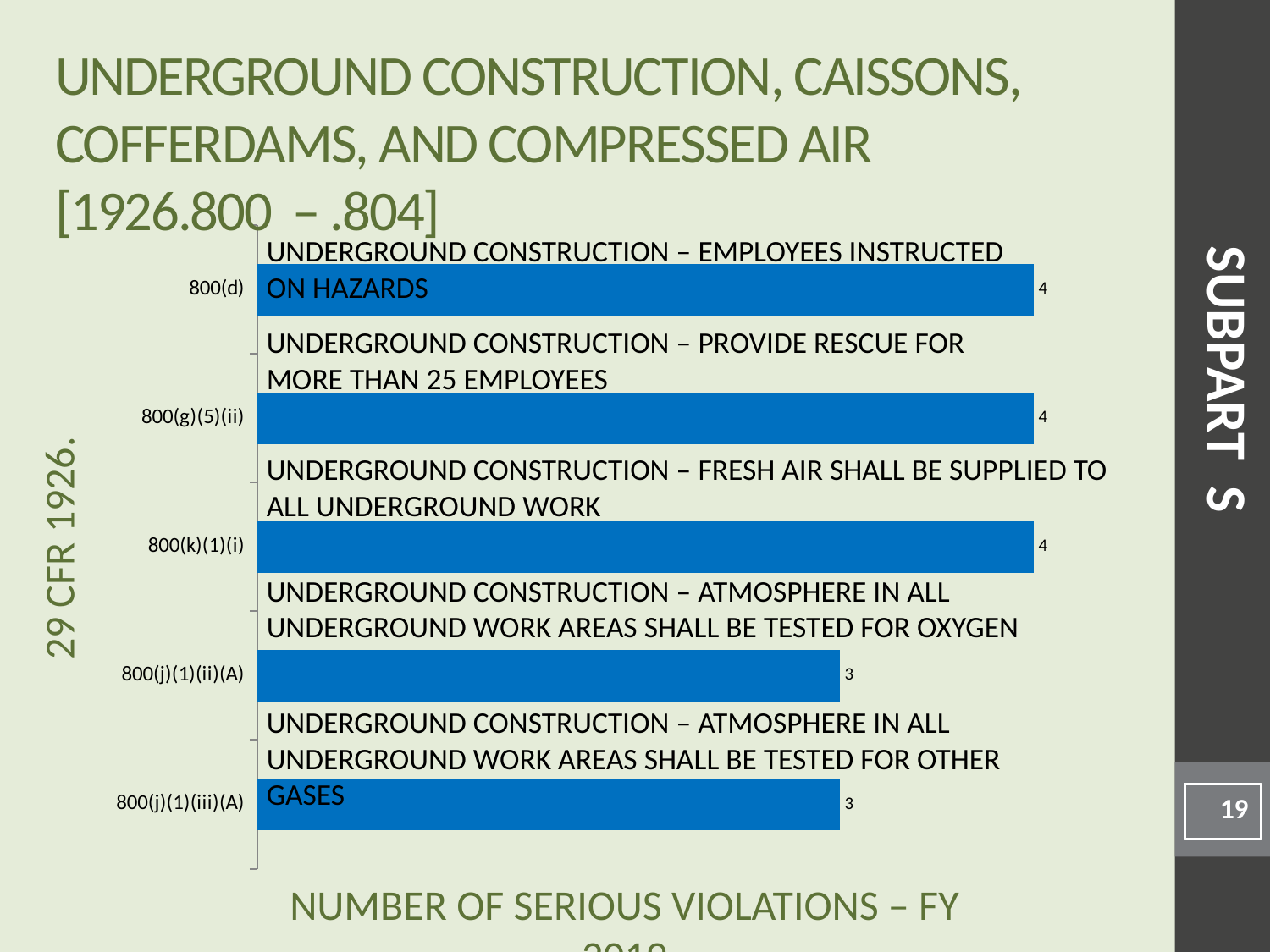
Which has more serious violations, 800(k)(1)(i) or 800(j)(1)(ii)(A)? 800(k)(1)(i) What is the number of serious violations for 800(j)(1)(iii)(A)? 3 How many categories (standards) are shown in the chart? 5 What is the difference between the values for 800(d) and 800(j)(1)(iii)(A)? 1 What is the number of serious violations for 800(d)? 4 What kind of chart is shown on the slide? Bar chart What is the vertical axis title of the chart? 29 CFR 1926. How many of the categories have a value of 4? 3 What is the number of serious violations for 800(j)(1)(ii)(A)? 3 What is the number of serious violations for 800(g)(5)(ii)? 4 What is the number of serious violations for 800(k)(1)(i)? 4 What is the total of all the values shown in the chart? 18